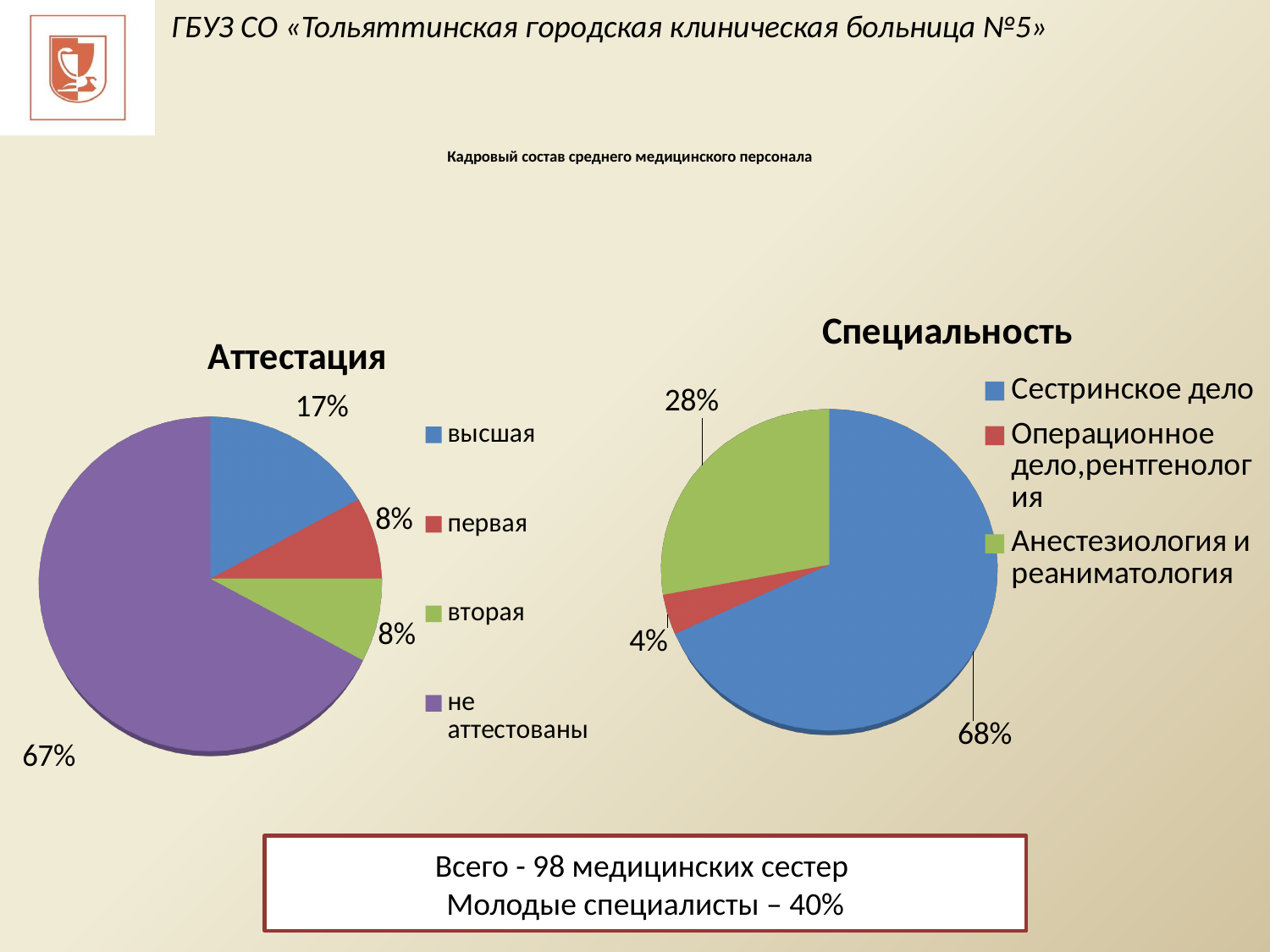
In the "Специальность" chart, what share is labelled for "Анестезиология и реаниматология"? 28% What kind of chart is the "Аттестация" chart? Pie chart In the "Специальность" chart, which category has the smallest slice? Операционное дело,рентгенология In the "Специальность" chart, how many categories does the legend list? 3 In the "Специальность" chart, which is larger: "Сестринское дело" or "Анестезиология и реаниматология"? Сестринское дело In the "Аттестация" chart, what is the difference between the shares for "не аттестованы" and "высшая"? 50% In the "Специальность" chart, what colour is the slice for "Сестринское дело"? Blue In the "Аттестация" chart, how many categories does the legend list? 4 In the "Аттестация" chart, what share is labelled for "не аттестованы"? 67% In the "Аттестация" chart, what share is labelled for "высшая"? 17% In the "Специальность" chart, what share is labelled for "Сестринское дело"? 68% In the "Аттестация" chart, which category has the largest slice? не аттестованы